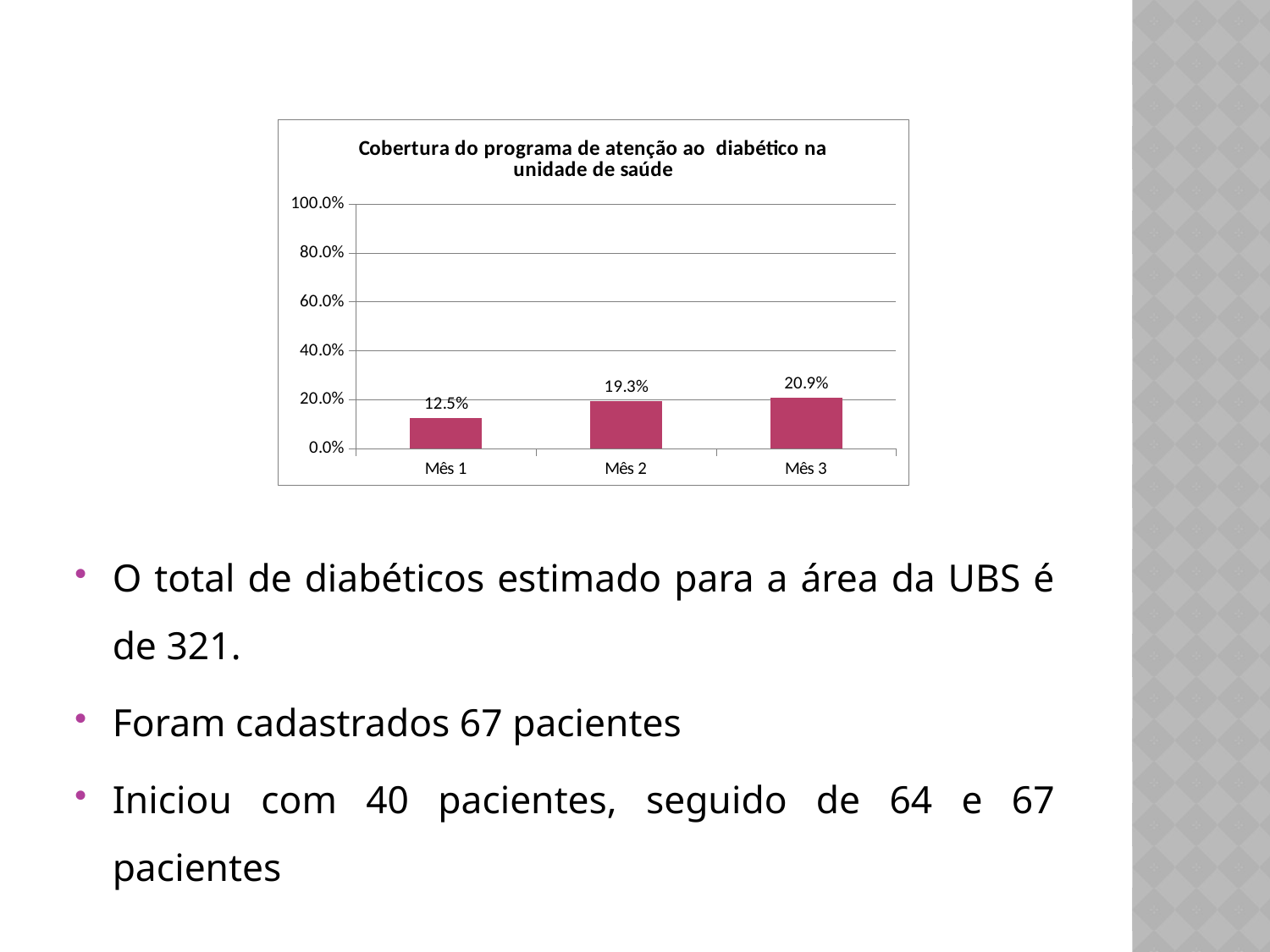
What is the difference between the values for Mês 3 and Mês 1? 8.4% Which month has the lowest value? Mês 1 Which is larger, the value for Mês 2 or the value for Mês 1? Mês 2 Do the values rise or fall from Mês 1 to Mês 3? rise How many months are shown on the x axis? 3 What is the value for Mês 2? 19.3% What kind of chart is shown on the slide? bar chart What is the value for Mês 3? 20.9% What is the difference between the values for Mês 2 and Mês 1? 6.8% Which month has the highest value? Mês 3 Is the value for Mês 3 greater or less than 40.0%? less What is the value for Mês 1? 12.5%